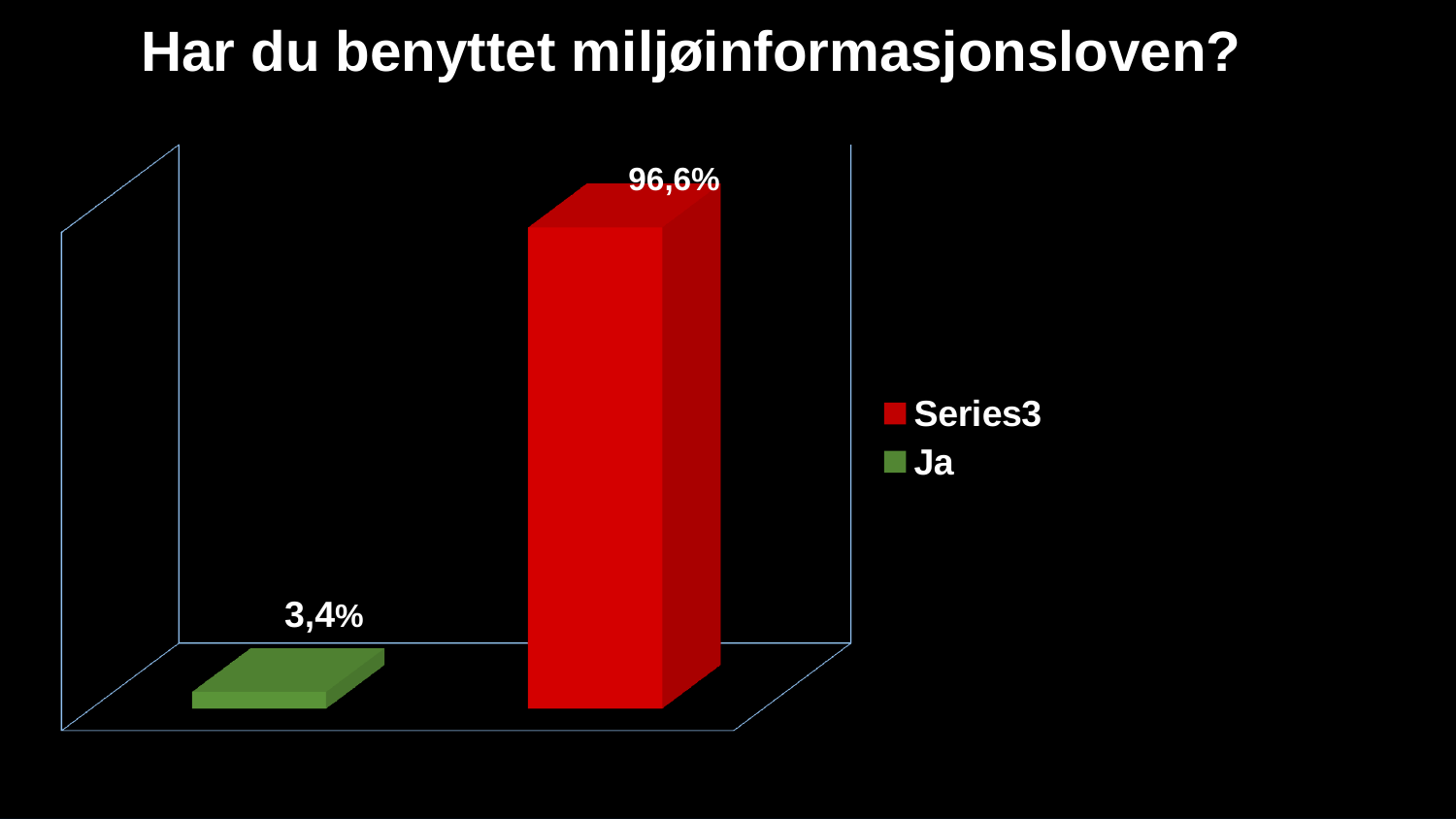
What value is shown for the Ja series? 3,4% What value is shown for the Series3 series? 96,6% What colour is the bar for the Ja series? Green How many bars are plotted in the chart? 2 What kind of chart is shown on the slide? Bar chart Which series has the lowest value? Ja What is the difference between the Series3 value and the Ja value? 93,2% Which series has the highest value? Series3 How many series does the legend list? 2 Which is larger, the value for Ja or the value for Series3? Series3 What is the title of the chart? Har du benyttet miljøinformasjonsloven?